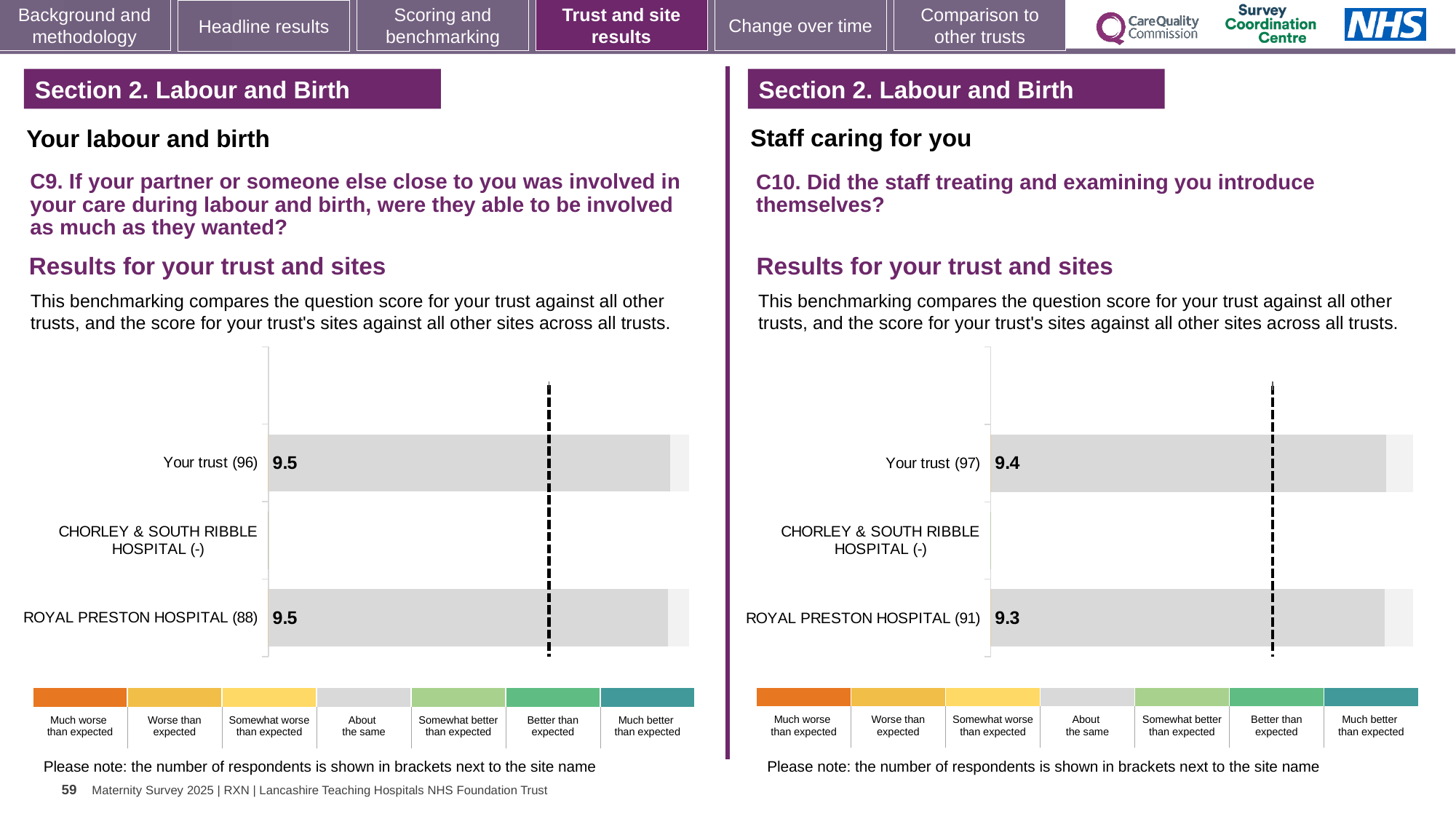
How many categories (rows) are listed in the left chart (C9)? 3 In the right chart (C10), what is the score for ROYAL PRESTON HOSPITAL? 9.3 In the right chart (C10), what is the difference between the score for Your trust and the score for ROYAL PRESTON HOSPITAL? 0.1 In the left chart (C9), what is the score for Your trust? 9.5 In the right chart (C10), how many respondents are shown in brackets for ROYAL PRESTON HOSPITAL? 91 In the left chart (C9), which site has no score bar shown? CHORLEY & SOUTH RIBBLE HOSPITAL In the left chart (C9), what is the score for ROYAL PRESTON HOSPITAL? 9.5 How many categories does the colour legend below the right chart (C10) list? 7 In the right chart (C10), what is the score for Your trust? 9.4 In the right chart (C10), which has the higher score, Your trust or ROYAL PRESTON HOSPITAL? Your trust What kind of chart is used in the right chart (C10)? Bar chart In the left chart (C9), how many respondents are shown in brackets for Your trust? 96